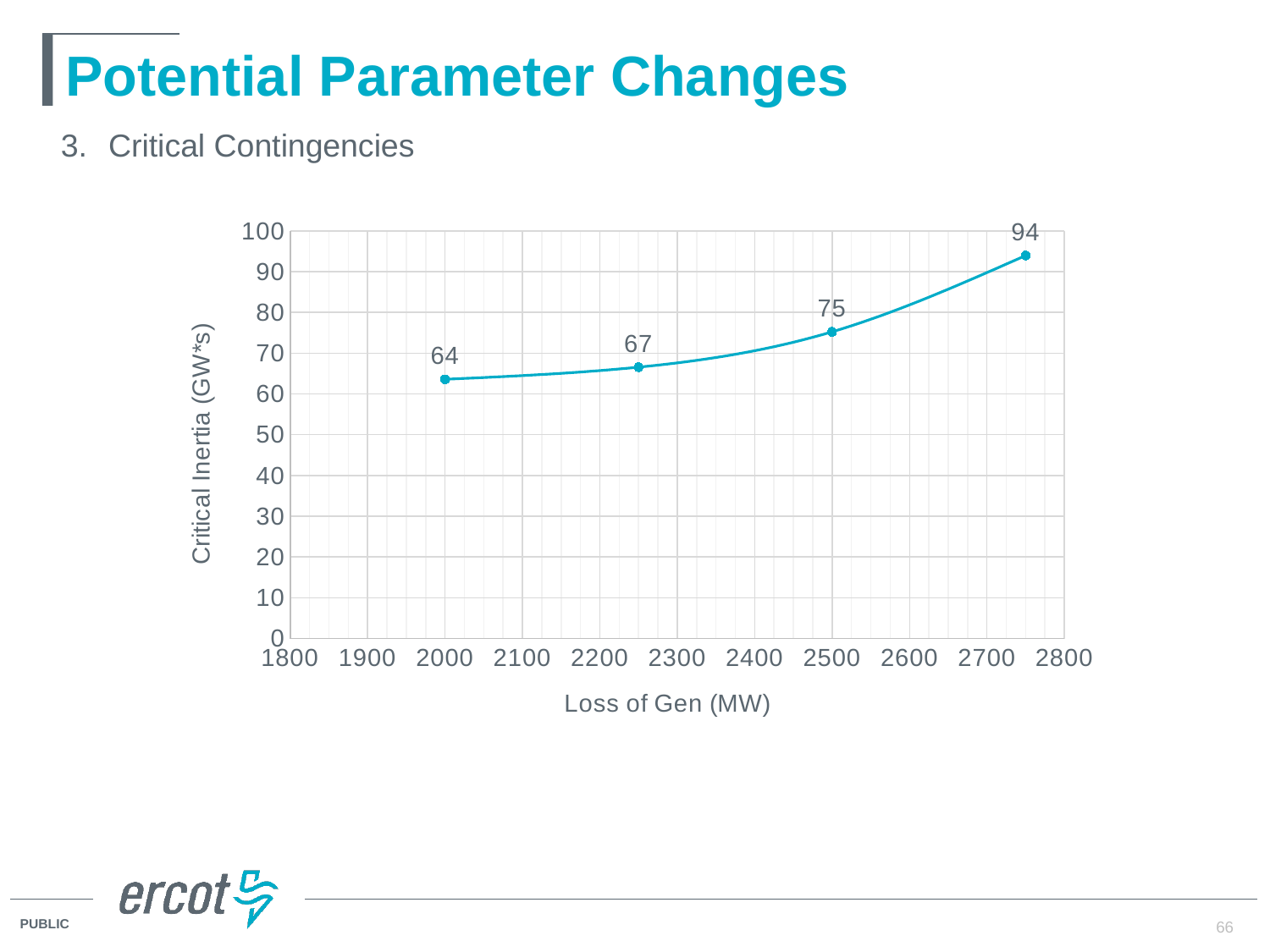
How much higher is the critical inertia at 2500 MW than at 2000 MW? 11 What is the difference between the highest and lowest critical inertia values plotted? 30 Which is larger, the critical inertia at 2000 MW or at 2500 MW? 2500 MW What is the lowest critical inertia value plotted? 64 What is the critical inertia value at a loss of gen of 2000 MW? 64 What is the data label on the rightmost point of the line? 94 What kind of chart is shown on the slide? Line chart Which point has the highest critical inertia value? The rightmost point, 94 What is the critical inertia value at a loss of gen of 2500 MW? 75 Does critical inertia rise or fall as loss of gen increases? Rises How many data points are plotted on the chart? 4 What is the data label on the second point from the left? 67